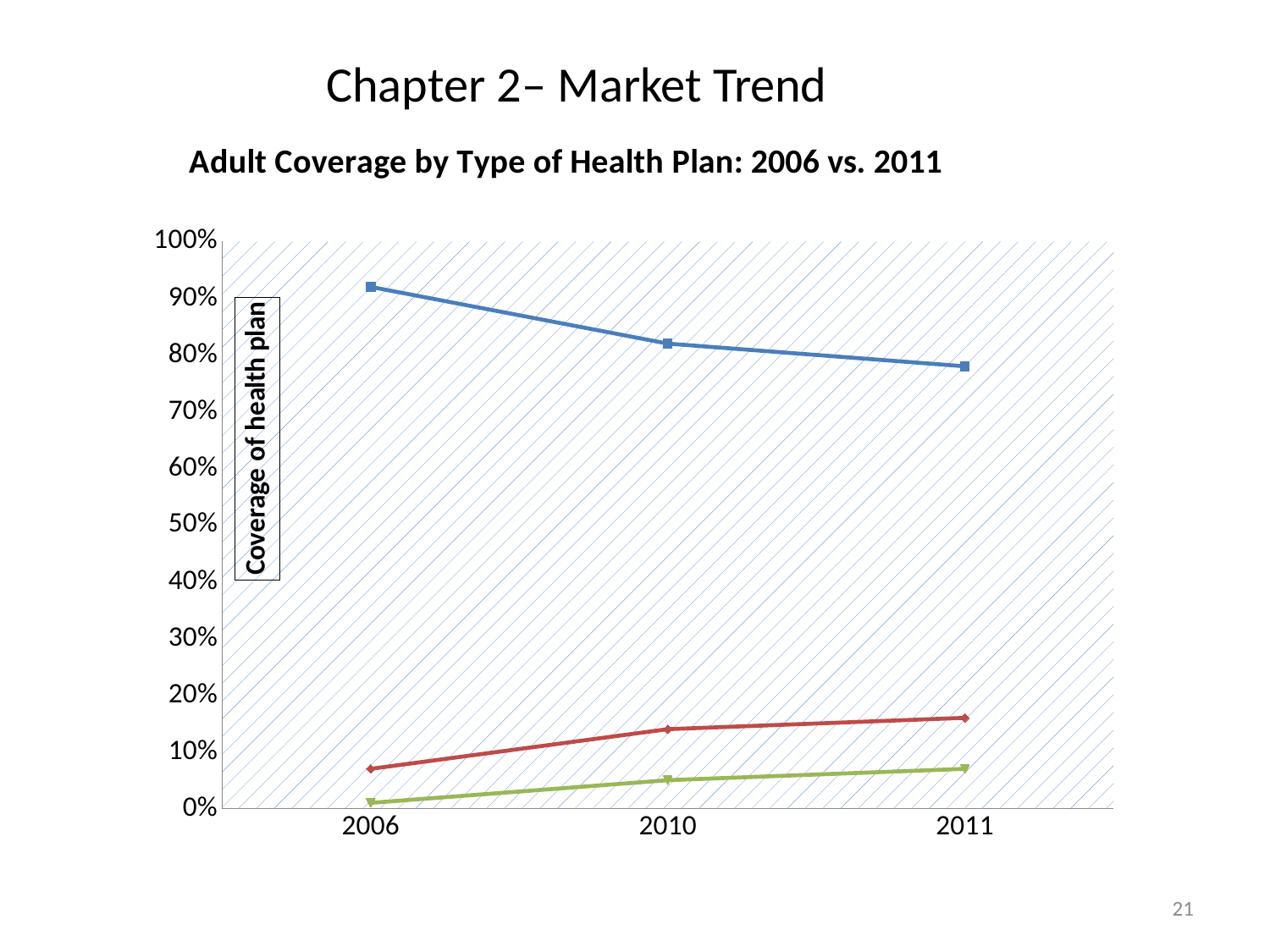
In which year is the blue line at its highest? 2006 What is the title of the chart? Adult Coverage by Type of Health Plan: 2006 vs. 2011 How many lines are plotted on the chart? 3 What kind of chart is shown on the slide? line chart Is the value of the red line in 2011 greater or less than 10%? greater Does the blue line rise or fall from 2006 to 2011? fall How many years are shown on the x axis of the chart? 3 In 2011, which line has the larger value, the red line or the green line? red line Does the red line rise or fall from 2006 to 2011? rise What is the label on the vertical axis of the chart? Coverage of health plan Is the value of the blue line in 2011 greater or less than 80%? less In which year is the blue line at its lowest? 2011